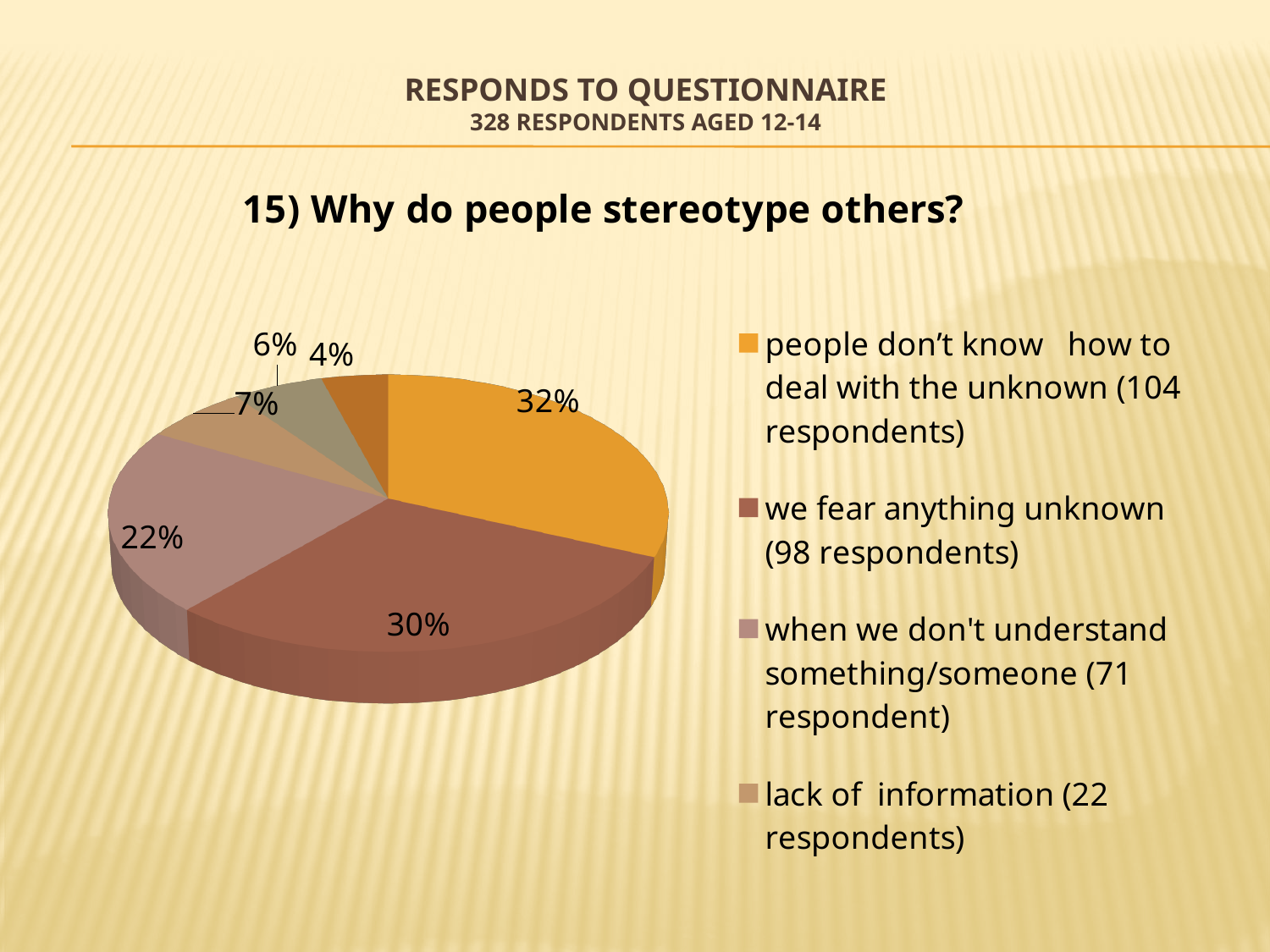
What is the title of the question shown above the chart? 15) Why do people stereotype others? What percentage of the pie is for 'people don't know how to deal with the unknown'? 32% What is the smallest percentage labelled on the pie? 4% What type of chart is shown on the slide? pie chart What percentage of the pie is for 'lack of information'? 7% What is the difference in percentage points between 'people don't know how to deal with the unknown' and 'we fear anything unknown'? 2 percentage points How many slices does the pie chart have? 6 Which reason has the largest share of the pie? people don't know how to deal with the unknown What percentage of the pie is for 'we fear anything unknown'? 30% According to the legend, how many respondents chose 'we fear anything unknown'? 98 Which has a larger share: 'when we don't understand something/someone' or 'lack of information'? when we don't understand something/someone